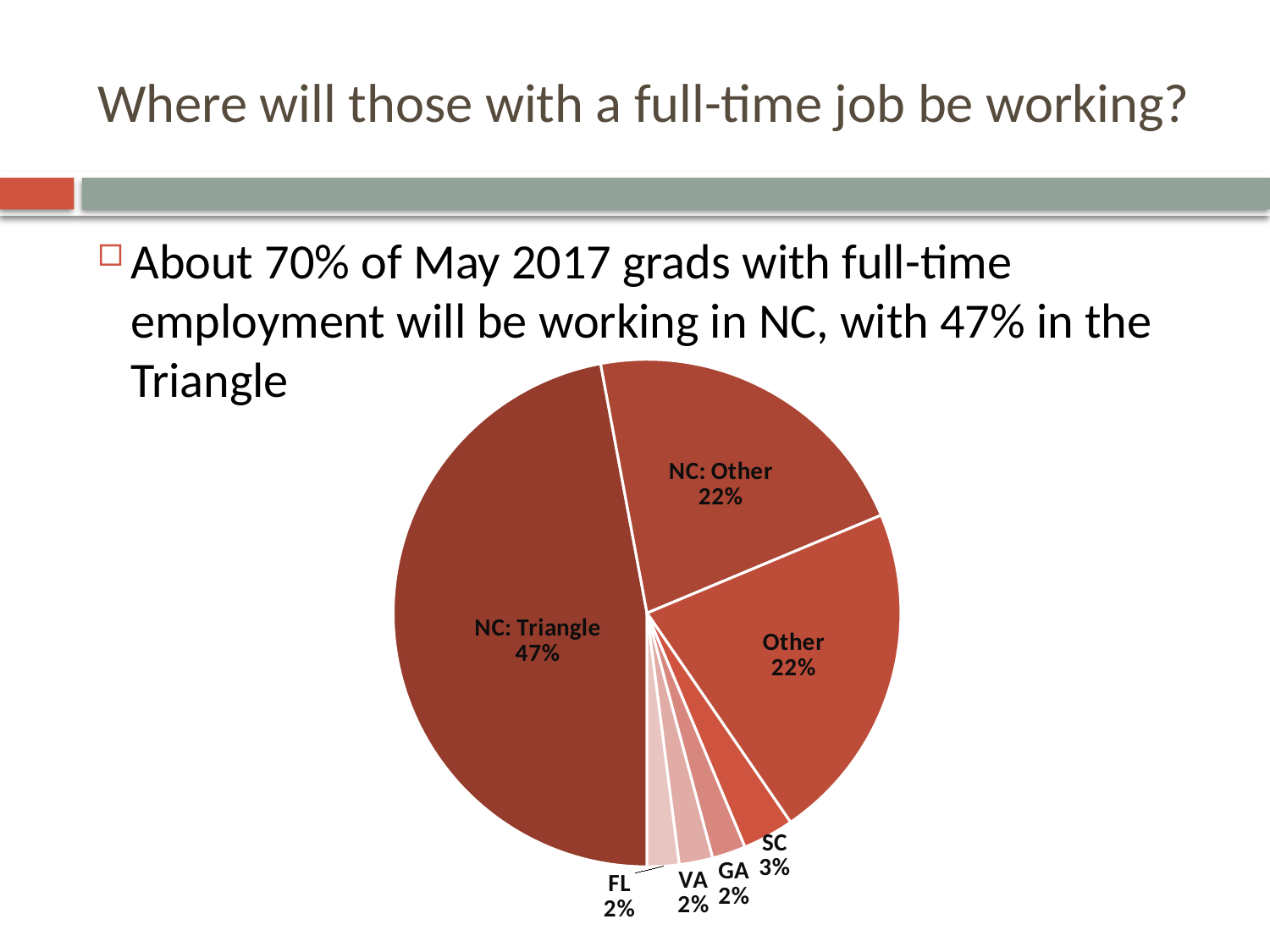
What is the difference in percentage points between the NC: Triangle slice and the Other slice? 25 Which slice of the pie is the largest? NC: Triangle Which is larger, the SC slice or the GA slice? SC What share of the pie does SC represent? 3% What kind of chart is shown on the slide? Pie chart How many slices does the pie chart have? 7 What share of the pie does NC: Other represent? 22% What share of the pie does NC: Triangle represent? 47% What share of the pie does VA represent? 2% What is the combined share of the NC: Triangle and NC: Other slices? 69% Which is larger, the NC: Triangle slice or the NC: Other slice? NC: Triangle What share of the pie does FL represent? 2%